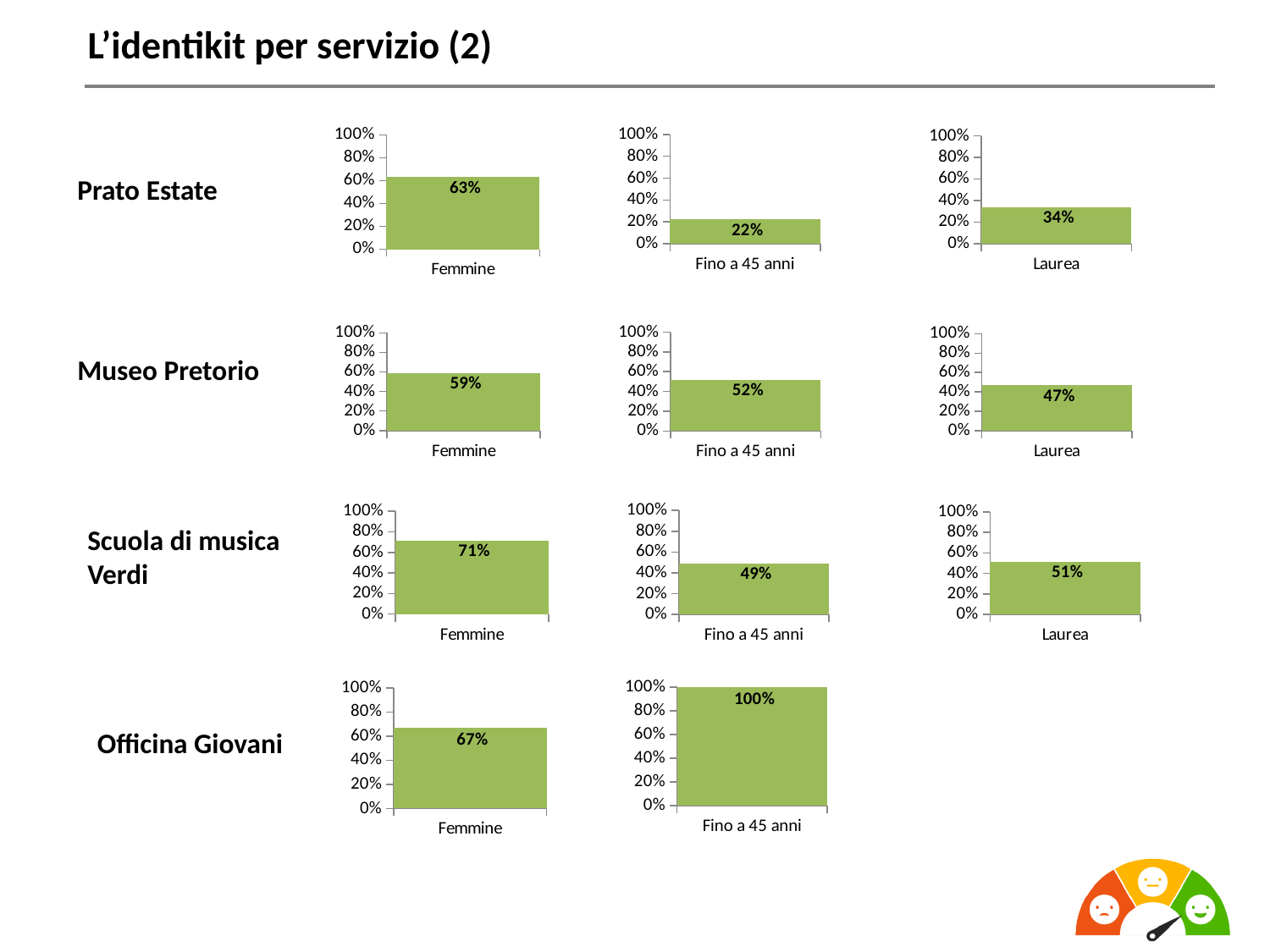
Across the Fino a 45 anni charts, which service row has the lowest value? Prato Estate In the Prato Estate row, what value is shown in the Fino a 45 anni chart? 22% Across the Femmine charts, which service row has the highest value? Scuola di musica Verdi In the Museo Pretorio row, what value is shown in the Laurea chart? 47% How many small charts are shown on the slide in total? 11 In the Museo Pretorio row, which is larger: the Femmine value or the Fino a 45 anni value? Femmine In the Scuola di musica Verdi row, what value is shown in the Femmine chart? 71% What is the difference between the Femmine value and the Laurea value in the Prato Estate row? 29% In the Officina Giovani row, what value is shown in the Fino a 45 anni chart? 100% What kind of chart is used in the Officina Giovani Femmine chart? bar chart In the Prato Estate row, what value is shown in the Femmine chart? 63% What is the difference between the Fino a 45 anni value and the Laurea value in the Scuola di musica Verdi row? 2%